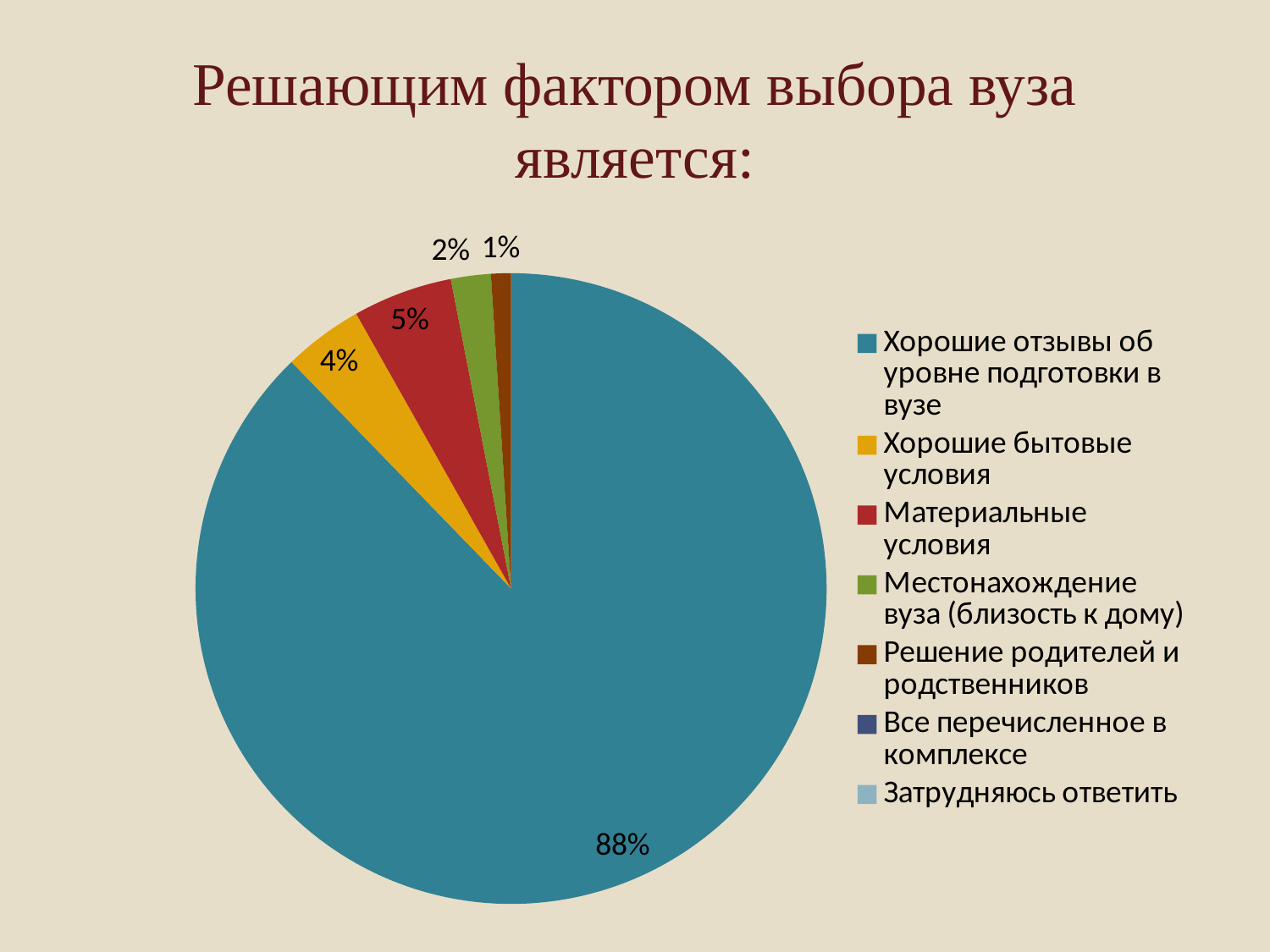
What share of the pie is labelled for "Материальные условия"? 5% What share of the pie is labelled for "Хорошие бытовые условия"? 4% How many entries does the legend list? 7 What is the difference in percentage points between the slice for "Хорошие отзывы об уровне подготовки в вузе" and the slice for "Материальные условия"? 83 Which category has the largest slice of the pie? Хорошие отзывы об уровне подготовки в вузе What is the title of the slide above the chart? Решающим фактором выбора вуза является: What kind of chart is shown on the slide? pie chart What share of the pie is labelled for "Хорошие отзывы об уровне подготовки в вузе"? 88% Which is larger: the slice for "Материальные условия" or the slice for "Хорошие бытовые условия"? Материальные условия What share of the pie is labelled for "Решение родителей и родственников"? 1% What share of the pie is labelled for "Местонахождение вуза (близость к дому)"? 2% What colour is the slice for "Хорошие бытовые условия"? yellow